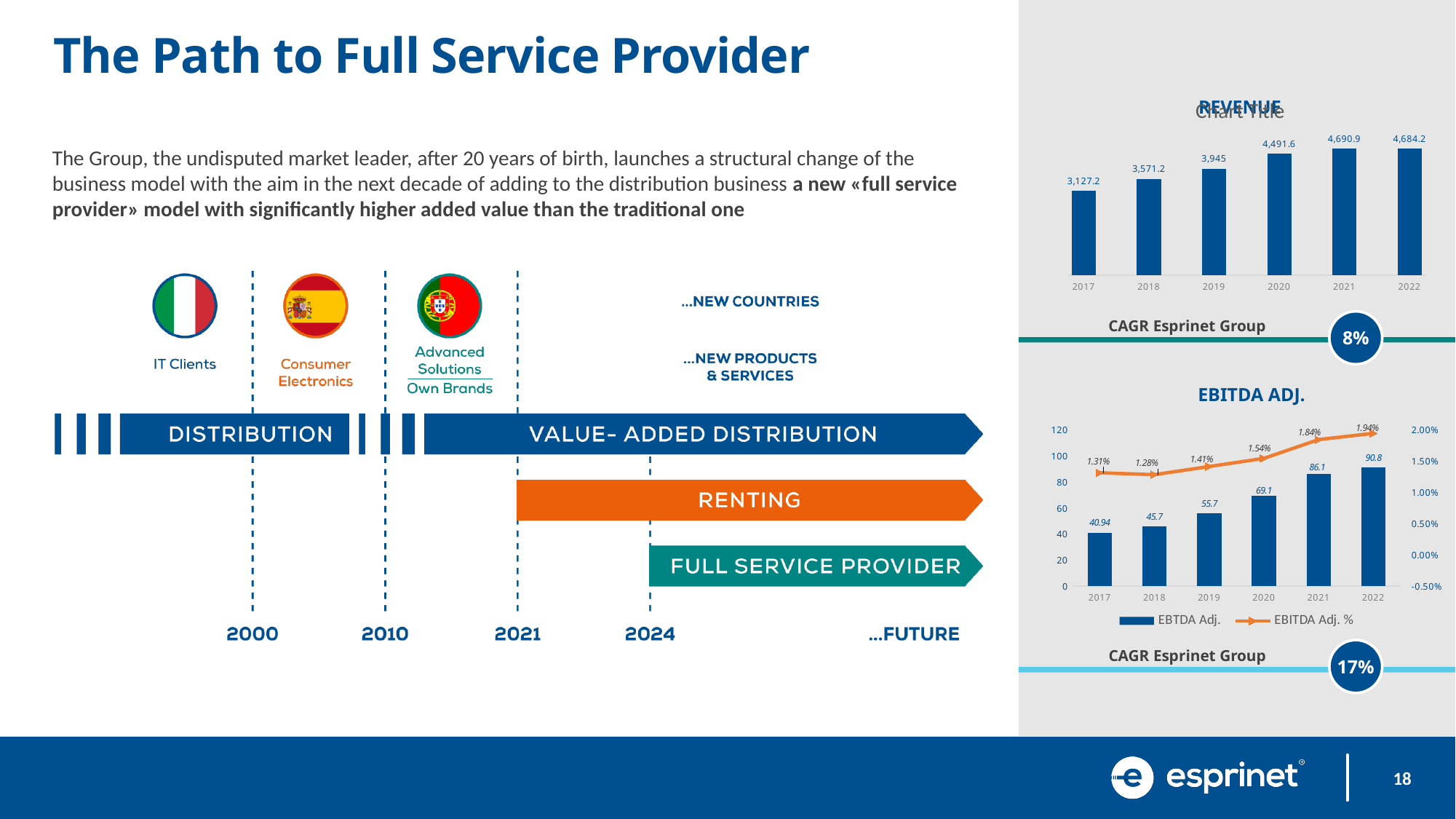
In the REVENUE chart, which year has the highest value? 2021 In the EBITDA ADJ. chart, what is the EBITDA Adj. % value for 2022? 1.94% In the EBITDA ADJ. chart, what is the EBITDA Adj. value for 2020? 69.1 In the REVENUE chart, how many years are plotted? 6 In the EBITDA ADJ. chart, which year has the lowest EBITDA Adj. % value? 2018 In the EBITDA ADJ. chart, do the EBITDA Adj. bar values rise or fall from 2017 to 2022? rise In the EBITDA ADJ. chart, how many series does the legend list? 2 In the REVENUE chart, what is the difference between the 2018 and 2017 values? 444 In the REVENUE chart, which year has the lowest value? 2017 What kind of chart is the REVENUE chart? bar chart In the EBITDA ADJ. chart, is the EBITDA Adj. value for 2021 larger than the value for 2019? Yes In the REVENUE chart, what is the value for 2019? 3,945